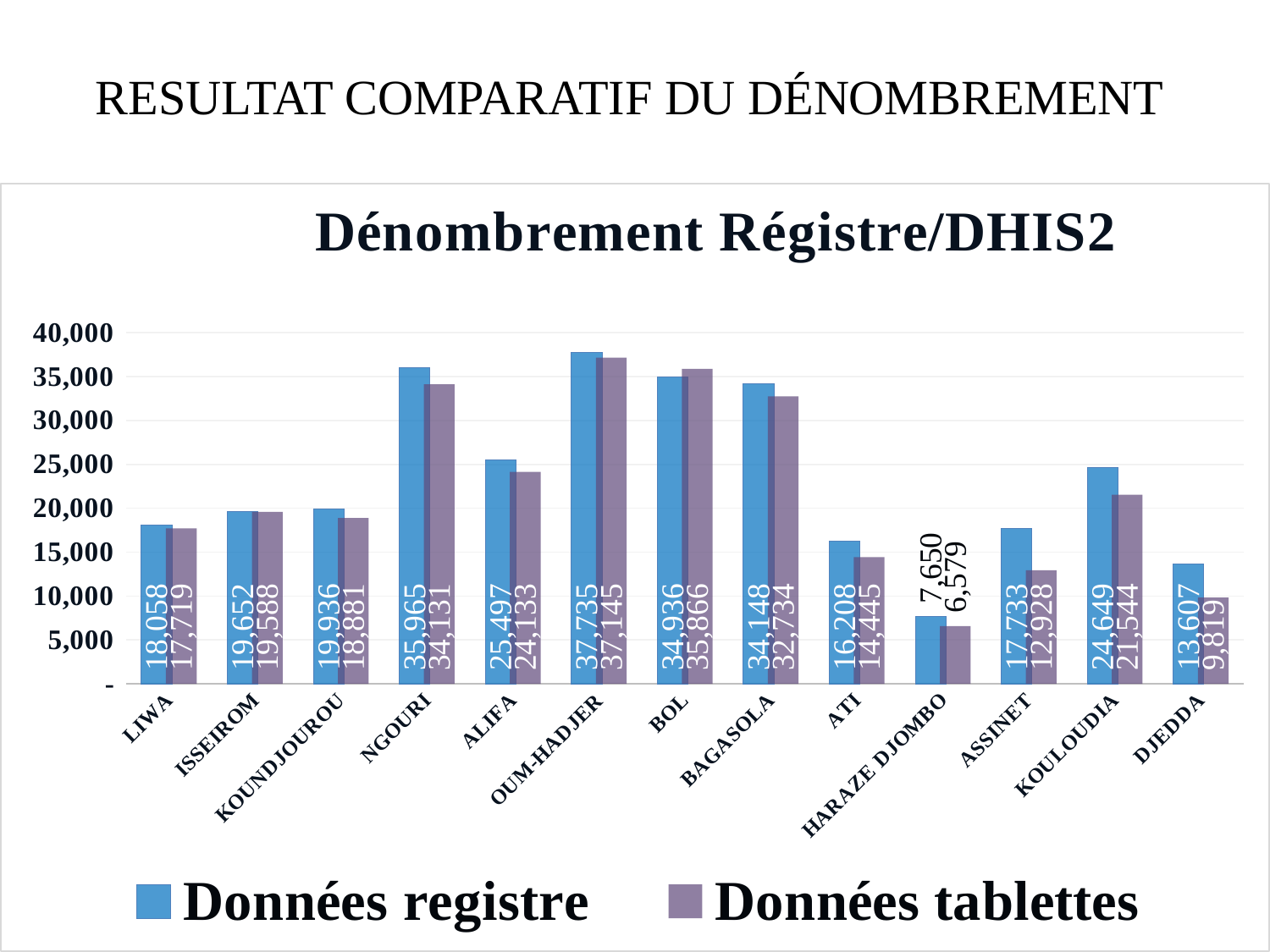
For BOL, which series has the larger value, Données registre or Données tablettes? Données tablettes How many categories are shown on the x axis? 13 What kind of chart is shown on the slide? Bar chart What is the value of Données tablettes for HARAZE DJOMBO? 6,579 Which category has the lowest value for Données tablettes? HARAZE DJOMBO How many series does the legend list? 2 What is the value of Données tablettes for DJEDDA? 9,819 What is the difference between Données registre and Données tablettes for DJEDDA? 3,788 What is the difference between Données registre and Données tablettes for KOULOUDIA? 3,105 What is the value of Données registre for LIWA? 18,058 Is the value of Données registre for ASSINET greater or less than 15,000? greater Which category has the highest value for Données registre? OUM-HADJER